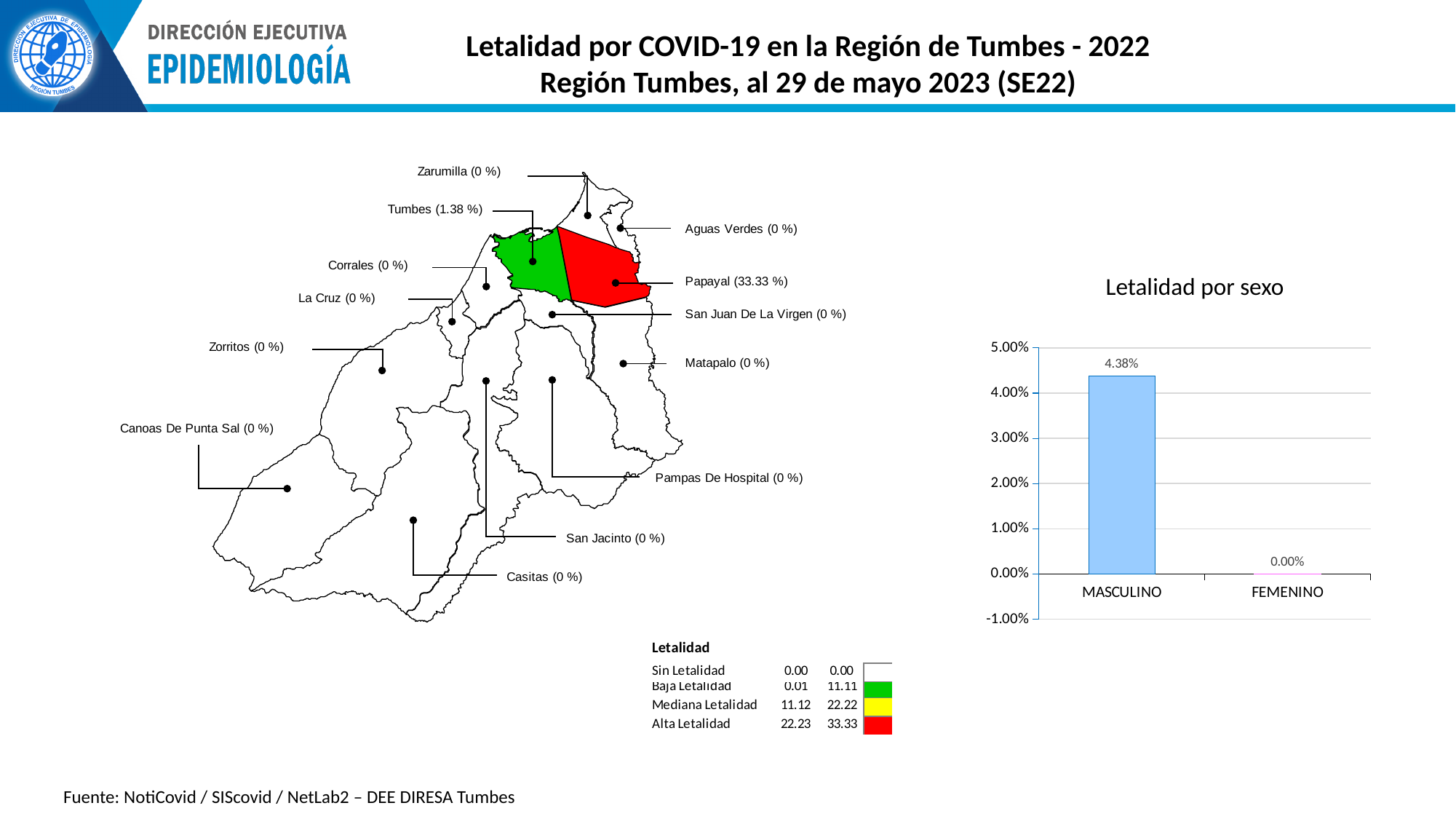
In the 'Letalidad por sexo' chart, is the value for MASCULINO greater or less than 4.00%? greater In the 'Letalidad por sexo' chart, what is the value for FEMENINO? 0.00% In the 'Letalidad por sexo' chart, which category has the highest value? MASCULINO What is the title of the chart on the right side of the slide? Letalidad por sexo In the 'Letalidad por sexo' chart, which is larger, the value for MASCULINO or for FEMENINO? MASCULINO In the 'Letalidad por sexo' chart, which category has the lowest value? FEMENINO In the 'Letalidad por sexo' chart, what is the value for MASCULINO? 4.38% In the 'Letalidad por sexo' chart, is the value for MASCULINO greater or less than 5.00%? less What kind of chart is the 'Letalidad por sexo' chart? bar chart In the 'Letalidad por sexo' chart, what colour is the MASCULINO bar? light blue In the 'Letalidad por sexo' chart, what is the difference between the MASCULINO and FEMENINO values? 4.38% How many categories are shown on the x axis of the 'Letalidad por sexo' chart? 2